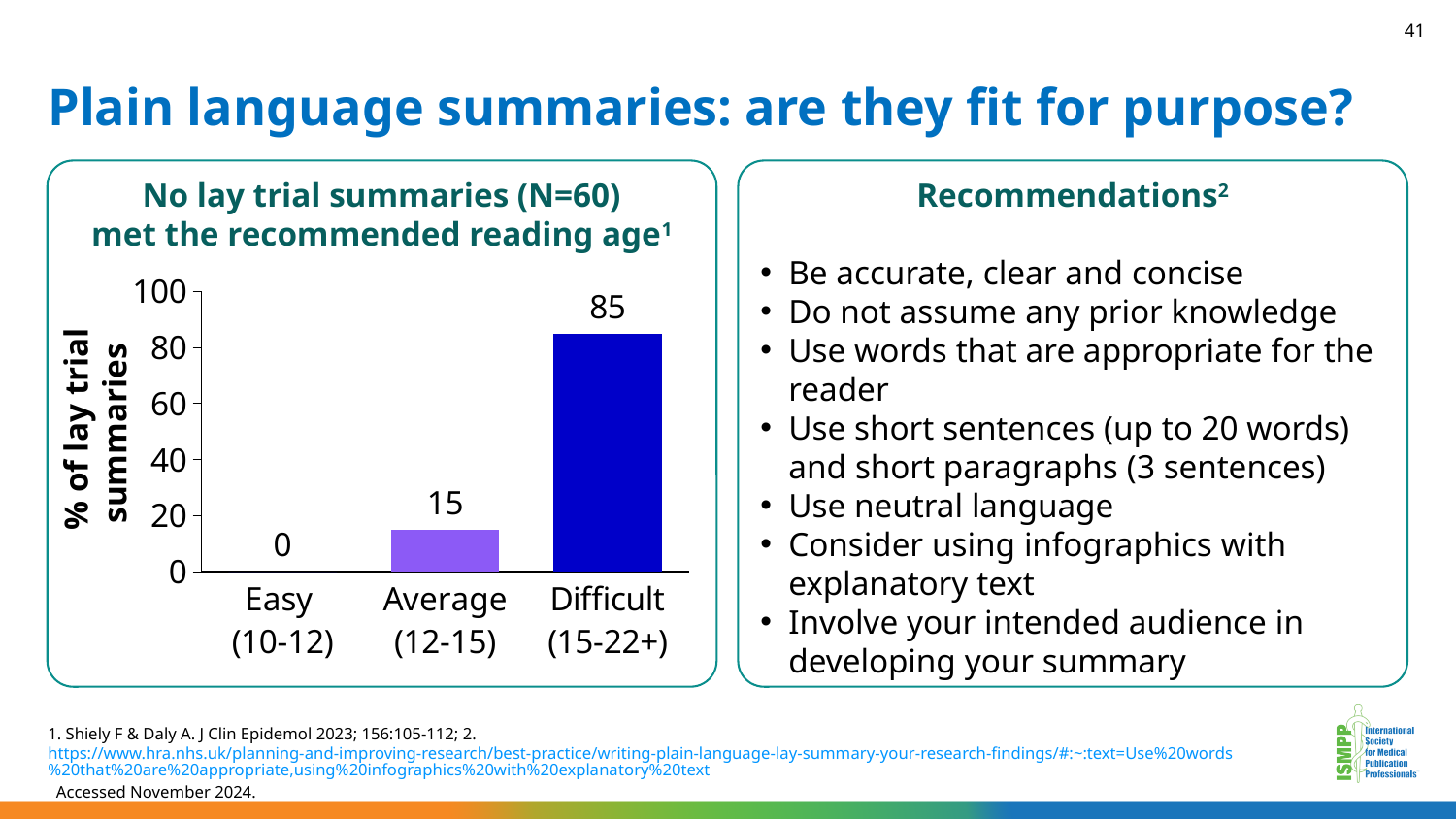
What kind of chart is shown on the slide? bar chart What is the value for the Average (12-15) category? 15 Is the value for Difficult (15-22+) greater or less than 80? greater Do the values rise or fall moving from Easy to Difficult along the x axis? rise Which is larger, the value for Average (12-15) or the value for Difficult (15-22+)? Difficult (15-22+) Which category has the lowest value? Easy (10-12) How many categories are shown on the x axis of the chart? 3 What is the value for the Difficult (15-22+) category? 85 What is the label of the y axis of the chart? % of lay trial summaries What is the difference between the values for Difficult (15-22+) and Average (12-15)? 70 Which category has the highest value? Difficult (15-22+) What is the value for the Easy (10-12) category? 0